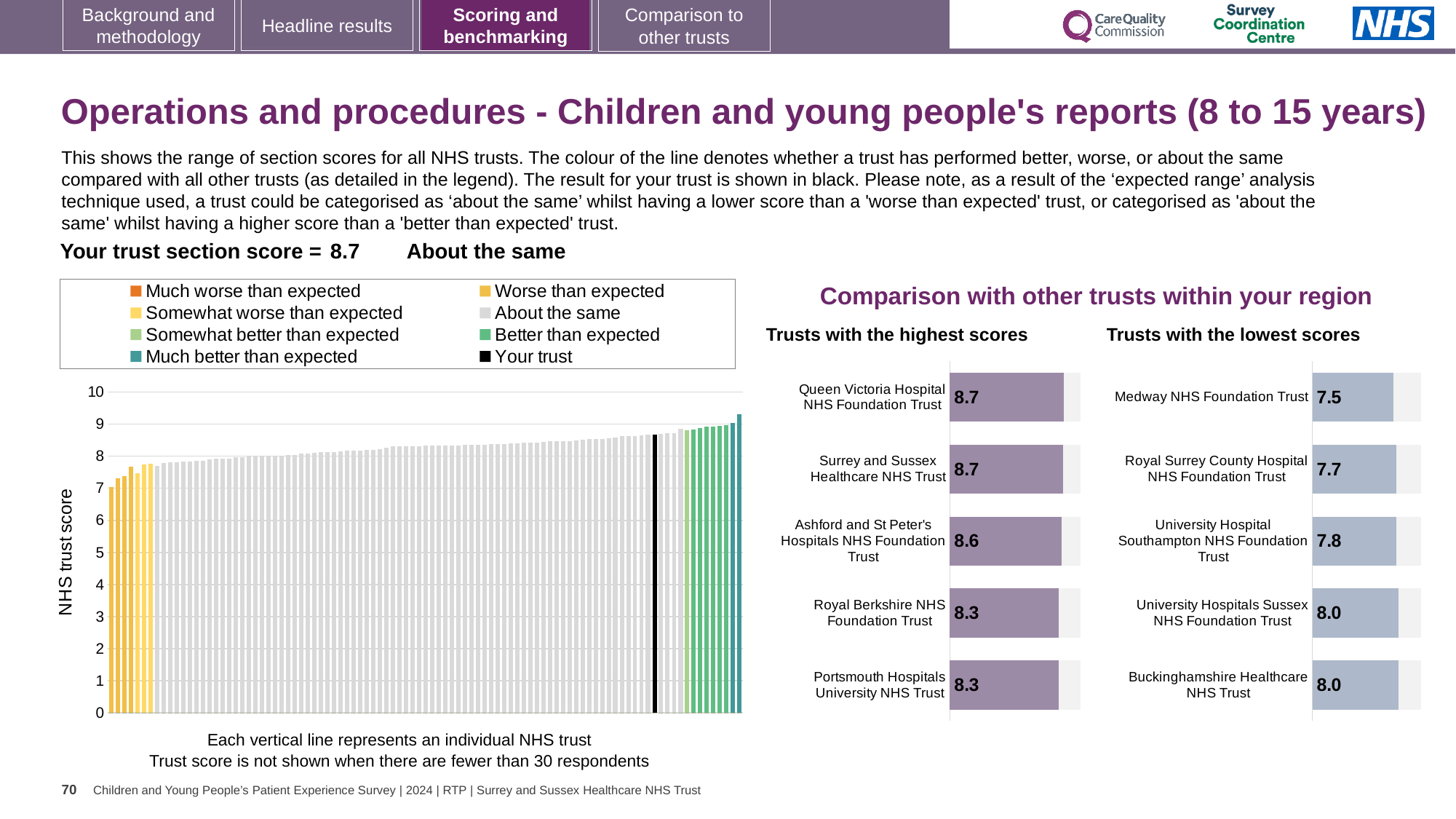
In the 'Trusts with the lowest scores' chart, which trust has the lowest score? Medway NHS Foundation Trust In the 'Trusts with the highest scores' chart, what is the score for Queen Victoria Hospital NHS Foundation Trust? 8.7 How many trusts are listed in the 'Trusts with the lowest scores' chart? 5 How many entries does the legend of the main chart on the left list? 8 In the 'Trusts with the highest scores' chart, what is the score for Royal Berkshire NHS Foundation Trust? 8.3 What kind of chart is the main chart on the left showing all NHS trusts? Bar chart Which is larger: the score for Ashford and St Peter's Hospitals NHS Foundation Trust in the highest scores chart, or the score for Royal Surrey County Hospital NHS Foundation Trust in the lowest scores chart? Ashford and St Peter's Hospitals NHS Foundation Trust In the 'Trusts with the highest scores' chart, what is the difference between the scores of Queen Victoria Hospital NHS Foundation Trust and Portsmouth Hospitals University NHS Trust? 0.4 In the 'Trusts with the lowest scores' chart, what is the difference between the scores of Buckinghamshire Healthcare NHS Trust and Medway NHS Foundation Trust? 0.5 In the 'Trusts with the lowest scores' chart, what is the score for Medway NHS Foundation Trust? 7.5 In the main chart on the left, do the trust scores rise or fall from left to right along the x axis? Rise In the 'Trusts with the lowest scores' chart, what is the score for University Hospital Southampton NHS Foundation Trust? 7.8